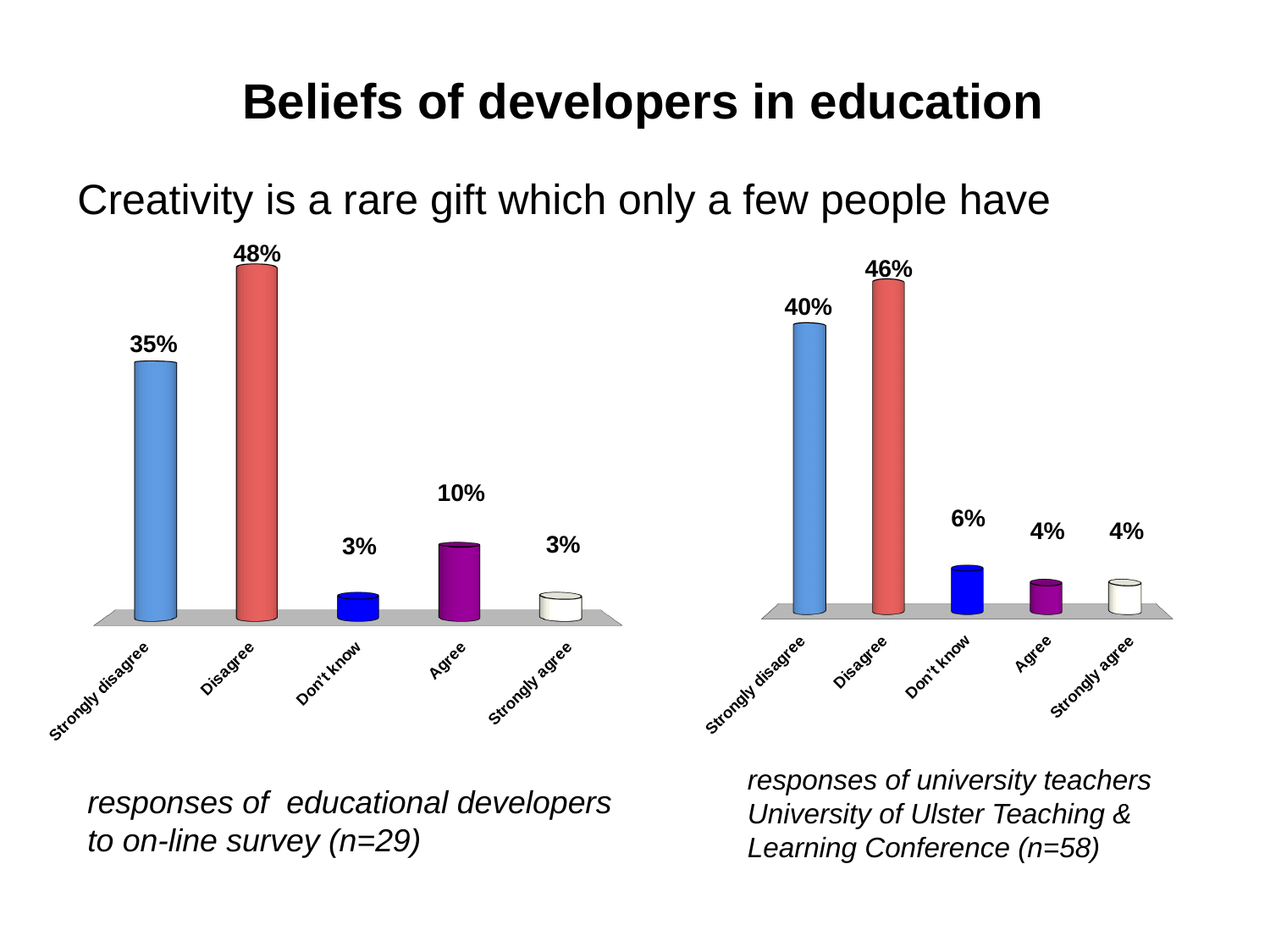
On the left chart (educational developers), what is the difference between Disagree and Strongly disagree? 13% On the right chart (university teachers), which category has the highest value? Disagree How many categories are shown on the right chart (university teachers)? 5 On the left chart (educational developers), what is the value for Agree? 10% What kind of chart is the left chart (educational developers)? Bar chart On the right chart (university teachers), what is the value for Strongly disagree? 40% On the right chart (university teachers), what is the difference between Disagree and Strongly disagree? 6% On the left chart (educational developers), what is the value for Disagree? 48% On the left chart (educational developers), which category has the highest value? Disagree On the left chart (educational developers), which is larger, Agree or Don't know? Agree On the right chart (university teachers), what is the value for Don't know? 6% What colour is the Disagree bar on the right chart (university teachers)? Red